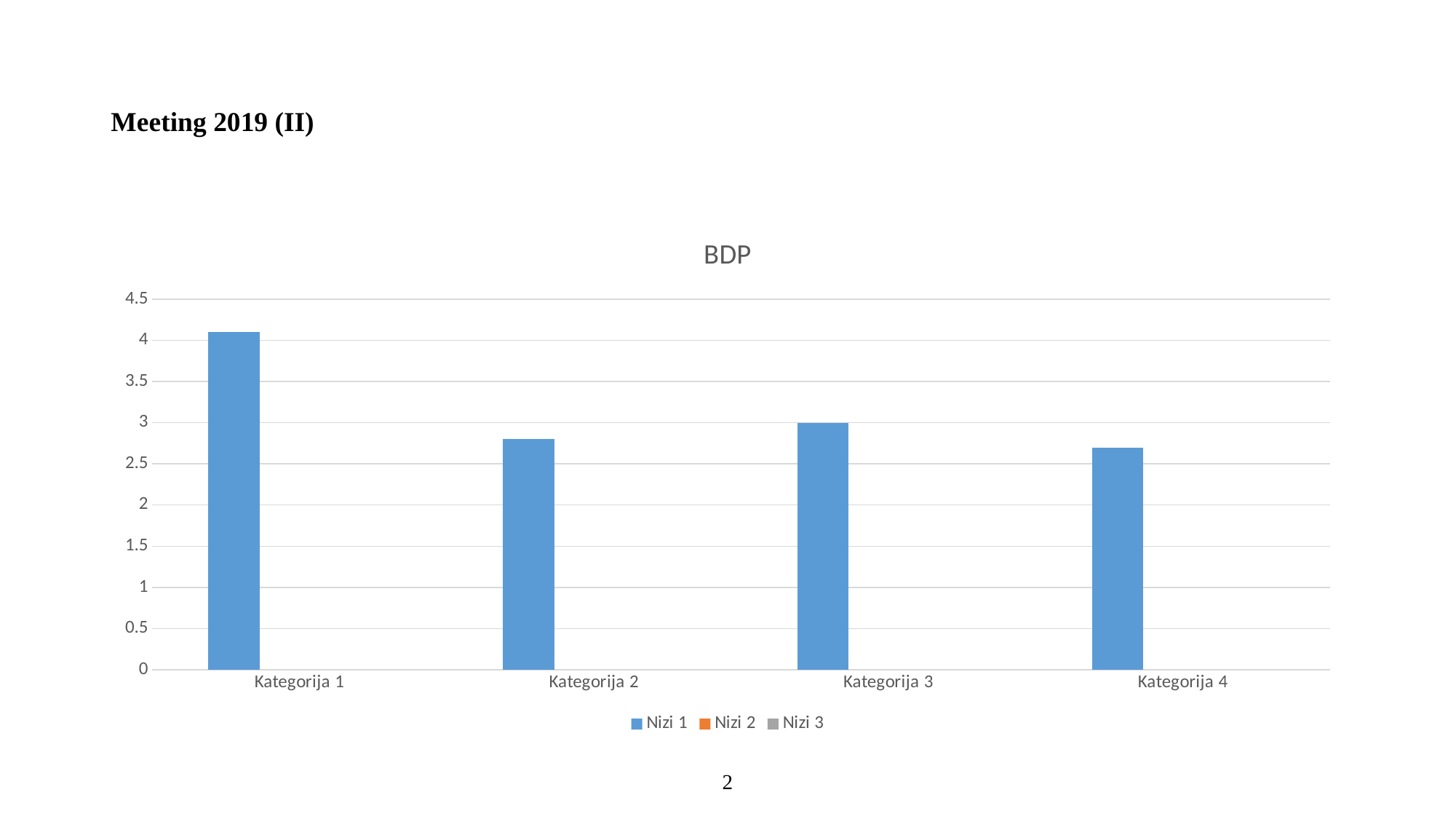
Which category has the highest bar in the BDP chart? Kategorija 1 Which is larger, the value for Kategorija 3 or Kategorija 4? Kategorija 3 How many series does the legend of the BDP chart list? 3 Which series in the legend is shown in blue? Nizi 1 What type of chart is shown on the slide? bar chart Is the value for Kategorija 4 greater or less than 3? less Is the value for Kategorija 3 greater or less than 2.5? greater Which is larger, the value for Kategorija 1 or Kategorija 2? Kategorija 1 What is the title of the chart? BDP Is the value for Kategorija 2 greater or less than 3? less How many categories are shown on the x axis of the BDP chart? 4